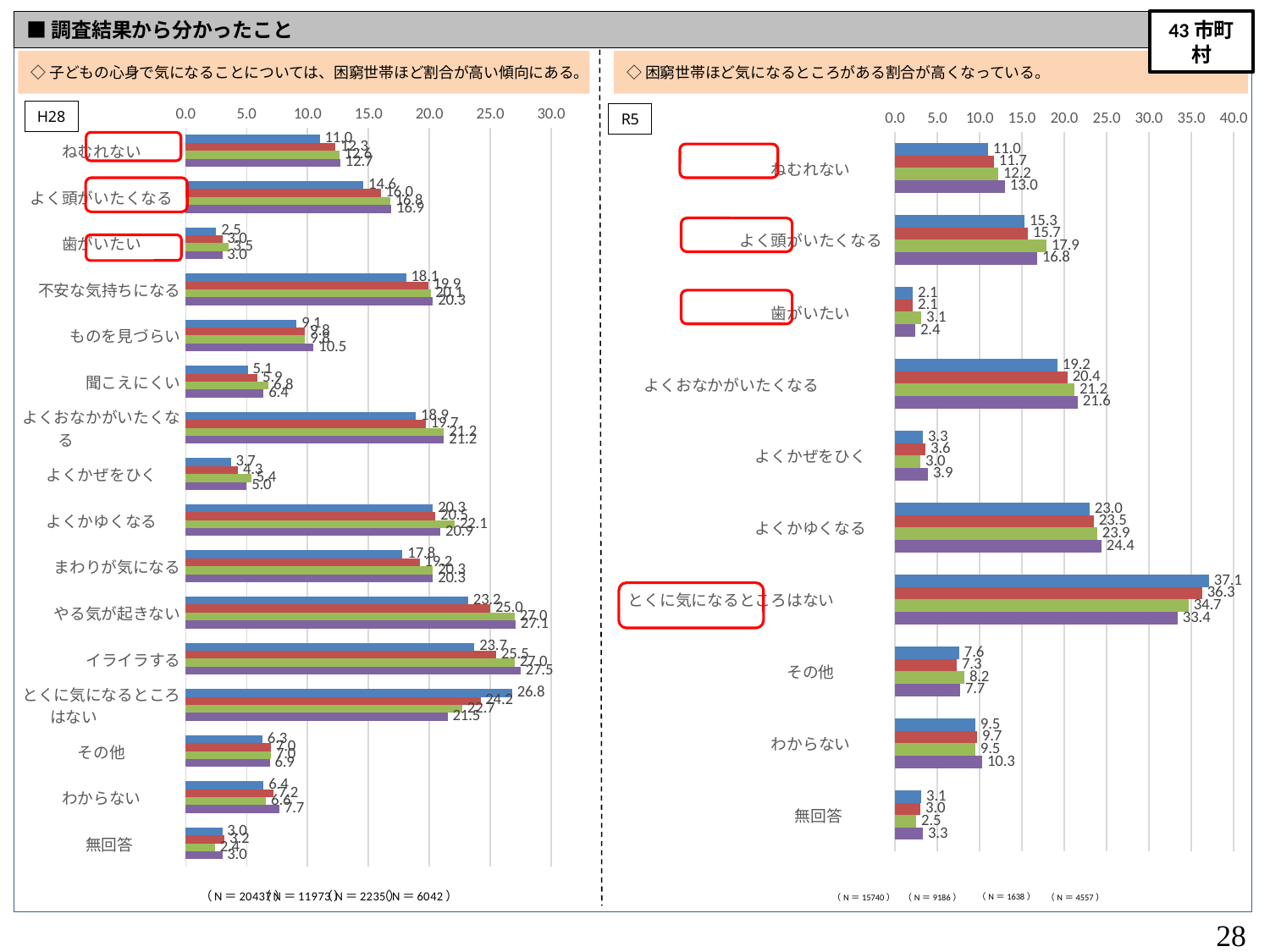
In the R5 chart on the right, what is the value of the blue bar for とくに気になるところはない? 37.1 In the R5 chart on the right, which category has the highest blue bar? とくに気になるところはない In the R5 chart on the right, how many categories are shown? 10 In the R5 chart on the right, what is the value of the green bar for よく頭がいたくなる? 17.9 In the H28 chart on the left, how many categories are shown? 16 In the H28 chart on the left, what is the value of the purple bar for イライラする? 27.5 In the R5 chart on the right, what is the difference between the blue bar (37.1) and the purple bar (33.4) for とくに気になるところはない? 3.7 In the R5 chart on the right, what is the value of the purple bar for よくおなかがいたくなる? 21.6 In the H28 chart on the left, is the blue bar for やる気が起きない greater or less than 20.0? greater In the R5 chart on the right, which category has the lowest blue bar? 歯がいたい In the H28 chart on the left, what is the value of the blue bar for とくに気になるところはない? 26.8 What type of chart is the R5 chart on the right? bar chart